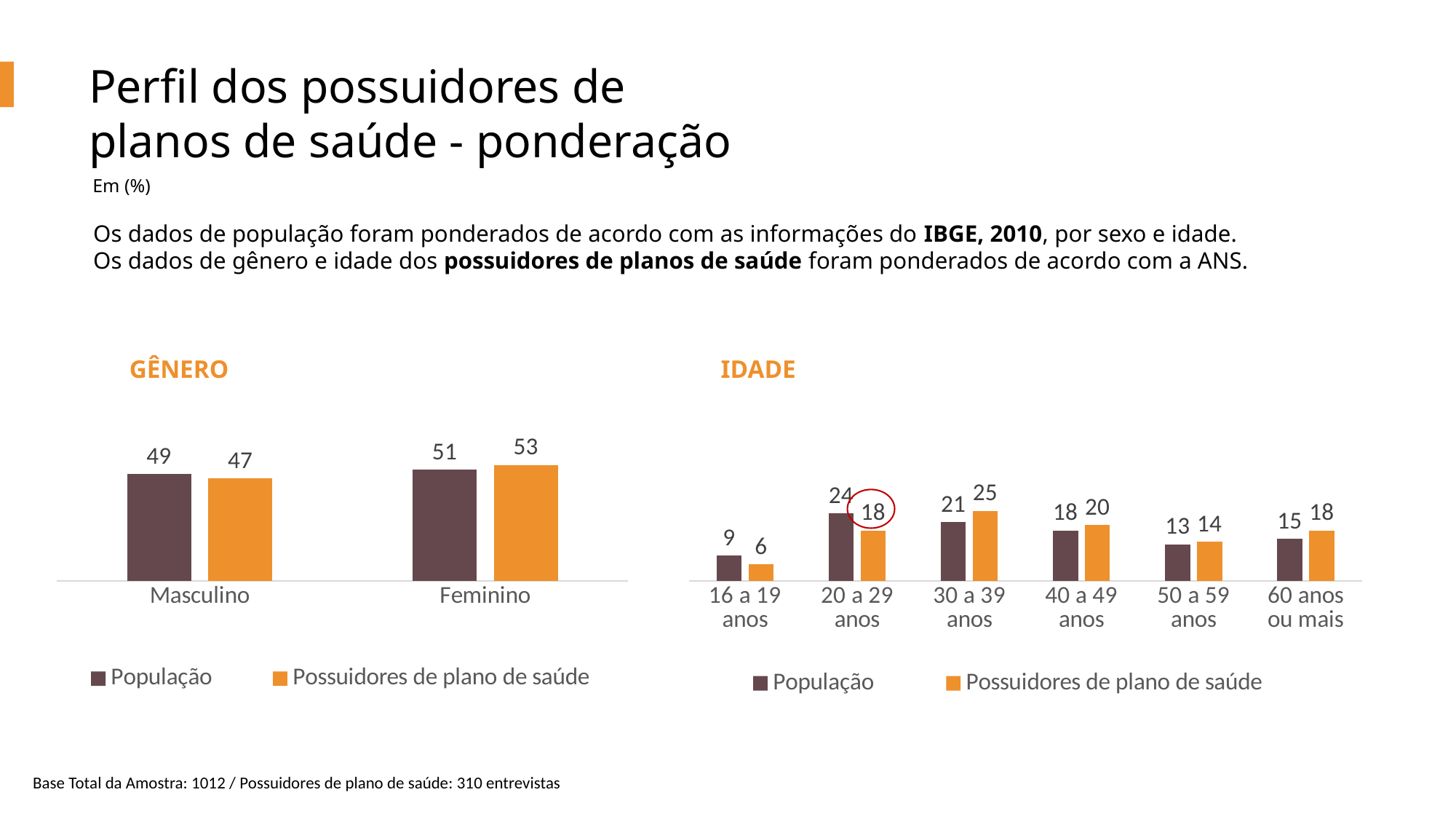
In the GÊNERO chart, what is the value for População for Masculino? 49 In the IDADE chart, what is the value for Possuidores de plano de saúde for 20 a 29 anos? 18 In the IDADE chart, how many age categories are shown? 6 In the GÊNERO chart, what is the difference between the Possuidores de plano de saúde values for Feminino and Masculino? 6 What kind of chart is the IDADE chart? Bar chart In the IDADE chart, which is larger for 60 anos ou mais: População or Possuidores de plano de saúde? Possuidores de plano de saúde In the IDADE chart, which age group has the highest value for Possuidores de plano de saúde? 30 a 39 anos In the IDADE chart, which age group has the lowest value for População? 16 a 19 anos In the GÊNERO chart, how many series does the legend list? 2 In the IDADE chart, what is the difference between População and Possuidores de plano de saúde for 20 a 29 anos? 6 In the GÊNERO chart, what is the value for Possuidores de plano de saúde for Feminino? 53 In the IDADE chart, what is the value for População for 16 a 19 anos? 9